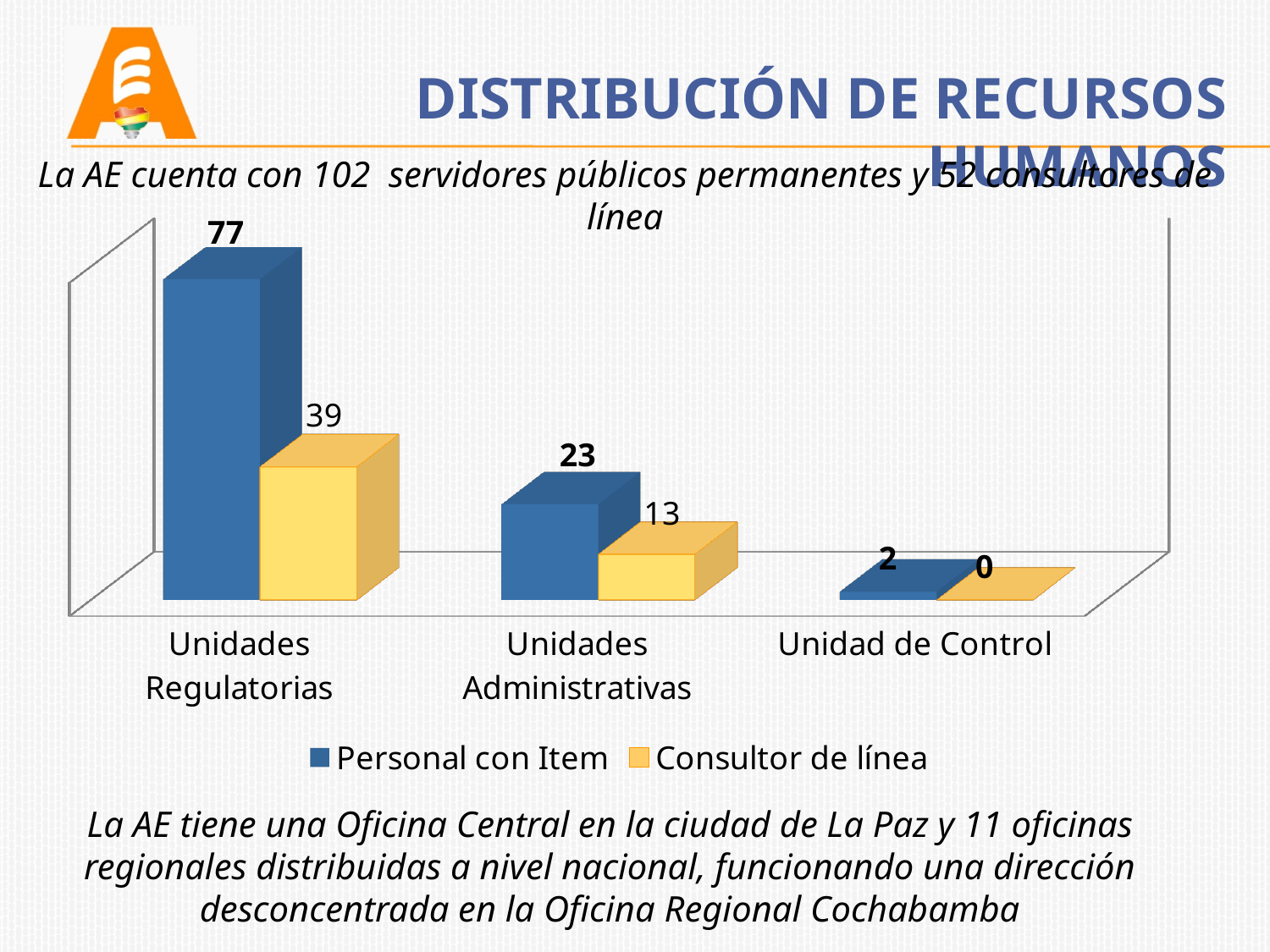
What is the value for Personal con Item in Unidades Administrativas? 23 How many categories are shown on the x axis? 3 Which is larger in Unidades Administrativas: Personal con Item or Consultor de línea? Personal con Item Which category has the lowest value for Consultor de línea? Unidad de Control What is the value for Personal con Item in Unidades Regulatorias? 77 What is the value for Consultor de línea in Unidades Regulatorias? 39 Which colour represents Consultor de línea in the legend? Yellow How many series does the legend list? 2 Which category has the highest value for Personal con Item? Unidades Regulatorias What is the difference between Personal con Item and Consultor de línea in Unidades Regulatorias? 38 What is the value for Consultor de línea in Unidad de Control? 0 What kind of chart is shown on the slide? Bar chart